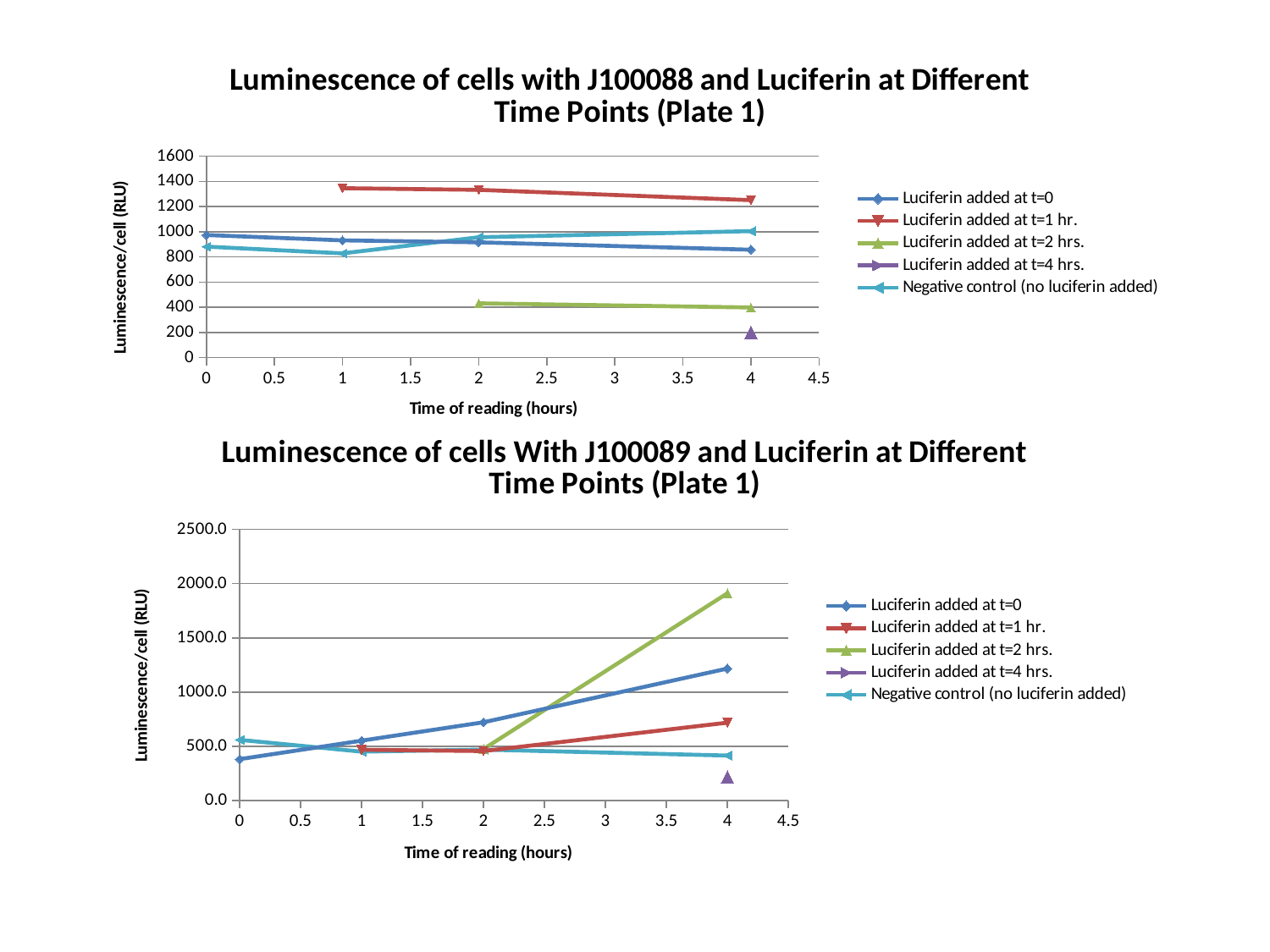
In the top chart (J100088), is the value for 'Luciferin added at t=4 hrs.' at 4 hours greater or less than 400? less In the top chart (J100088), which series has the lowest value at 4 hours? Luciferin added at t=4 hrs. In the bottom chart (J100089), does the 'Luciferin added at t=0' series rise or fall from 0 to 4 hours? rise In the bottom chart (J100089), at 4 hours, which is larger: 'Luciferin added at t=0' or 'Negative control (no luciferin added)'? Luciferin added at t=0 In the bottom chart (J100089), is the value for 'Luciferin added at t=2 hrs.' at 4 hours greater or less than 1500.0? greater In the top chart (J100088), is the value for 'Luciferin added at t=1 hr.' at 1 hour greater or less than 1200? greater How many series does the legend of the top chart (J100088) list? 5 In the bottom chart (J100089), which series has the lowest value at 4 hours? Luciferin added at t=4 hrs. In the top chart (J100088), does the 'Luciferin added at t=1 hr.' series rise or fall from 1 hour to 4 hours? fall In the bottom chart (J100089), which series has the highest value at 4 hours? Luciferin added at t=2 hrs. What kind of chart is the top chart, 'Luminescence of cells with J100088 and Luciferin at Different Time Points (Plate 1)'? Line chart In the top chart (J100088), which series has the highest value at 4 hours? Luciferin added at t=1 hr.